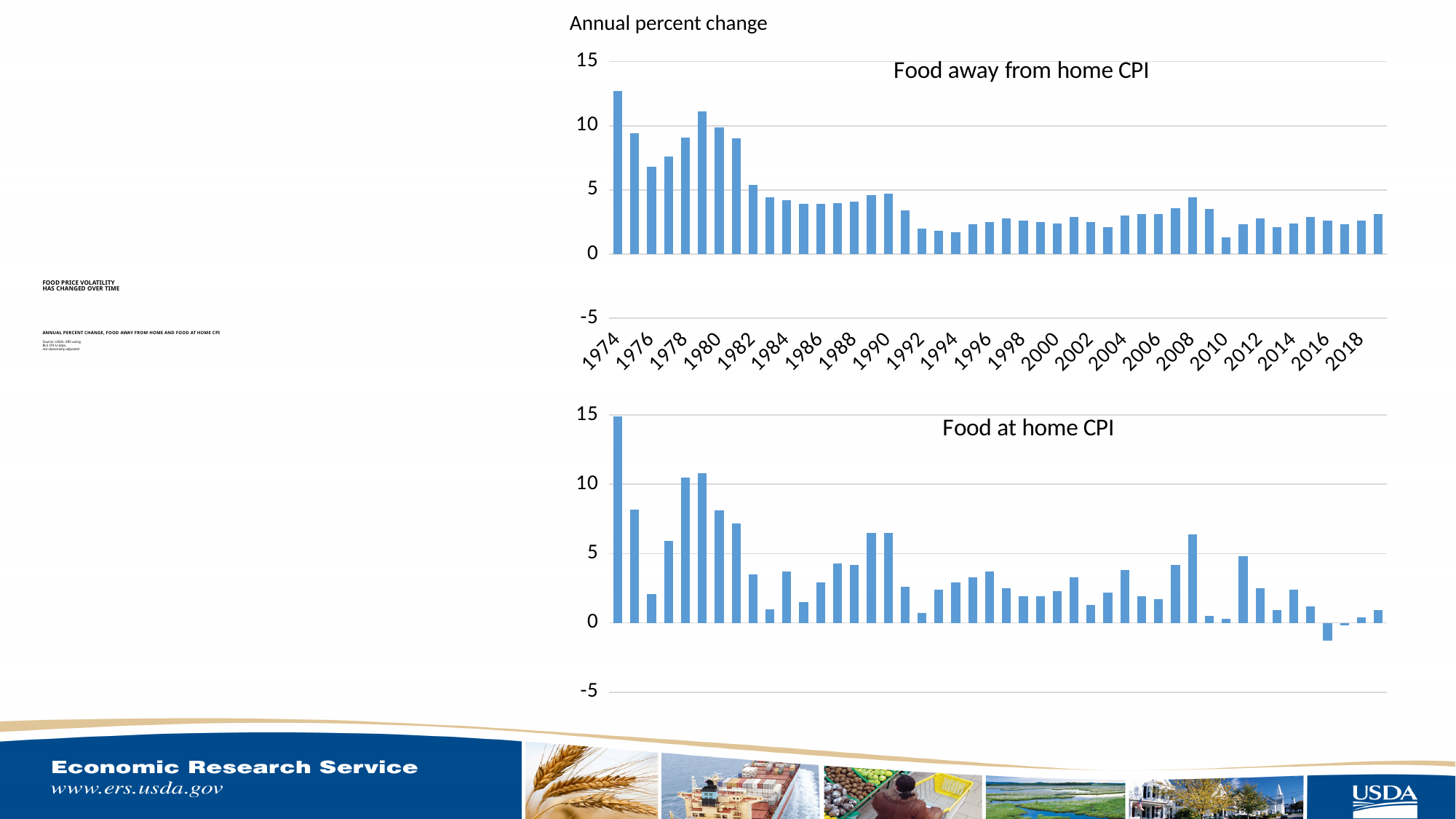
In the 'Food away from home CPI' chart, which year has the highest value? 1974 In the 'Food at home CPI' chart, which is larger, the value for 2008 or the value for 2010? 2008 In the 'Food at home CPI' chart, is the value for 1976 greater or less than 10? less What is the label shown above the y axis of the top chart? Annual percent change What kind of chart is the 'Food away from home CPI' chart? bar chart In the 'Food at home CPI' chart, which year has the highest value? 1974 In the 'Food away from home CPI' chart, which is larger, the value for 1974 or the value for 1976? 1974 In the 'Food away from home CPI' chart, is the value for 1984 greater or less than 5? less In the 'Food at home CPI' chart, which year has the lowest value? 2016 In the 'Food at home CPI' chart, is the value for 2008 greater or less than 5? greater In the 'Food away from home CPI' chart, do the values generally rise or fall from 1974 to 1992? fall